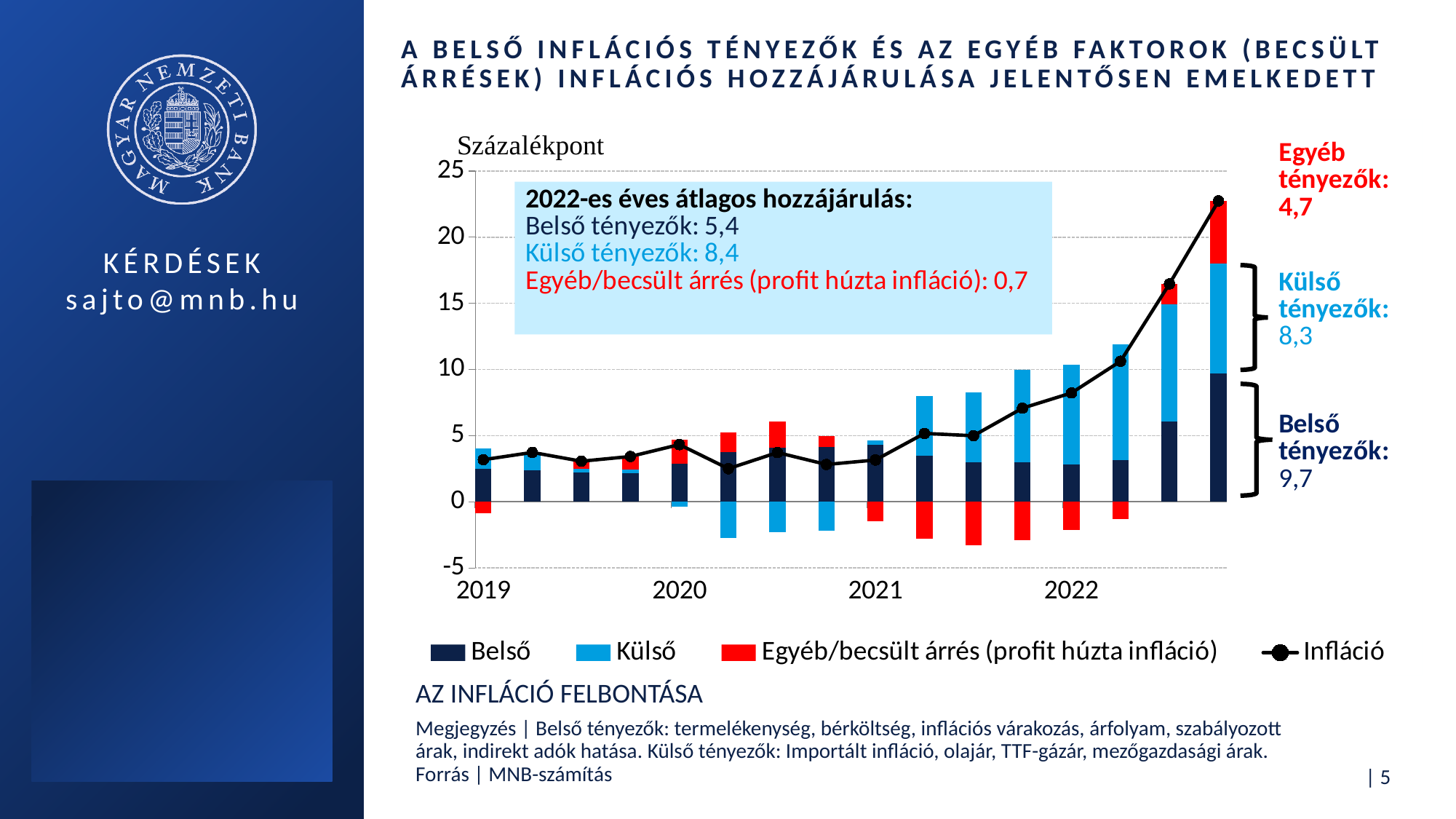
What unit is shown on the vertical axis of the chart? Százalékpont In the last bar, how much larger is the Belső tényezők contribution (9,7) than the Külső tényezők contribution (8,3)? 1,4 What kind of chart is shown on the slide? Stacked bar chart with a line How many series does the chart legend list? 4 Is the Infláció line value at the last point of the chart greater or less than 20? greater What is the contribution of Egyéb tényezők in the last bar of the chart, as annotated? 4,7 What is the contribution of Külső tényezők in the last bar of the chart, as annotated? 8,3 Which component is the largest in the last bar of the chart: Belső, Külső or Egyéb tényezők? Belső tényezők According to the text box, what was the 2022 annual average contribution of Külső tényezők? 8,4 What is the contribution of Belső tényezők in the last bar of the chart, as annotated? 9,7 What is the total of the last stacked bar (Belső 9,7 + Külső 8,3 + Egyéb 4,7)? 22,7 According to the text box, what was the 2022 annual average contribution of Egyéb/becsült árrés (profit húzta infláció)? 0,7